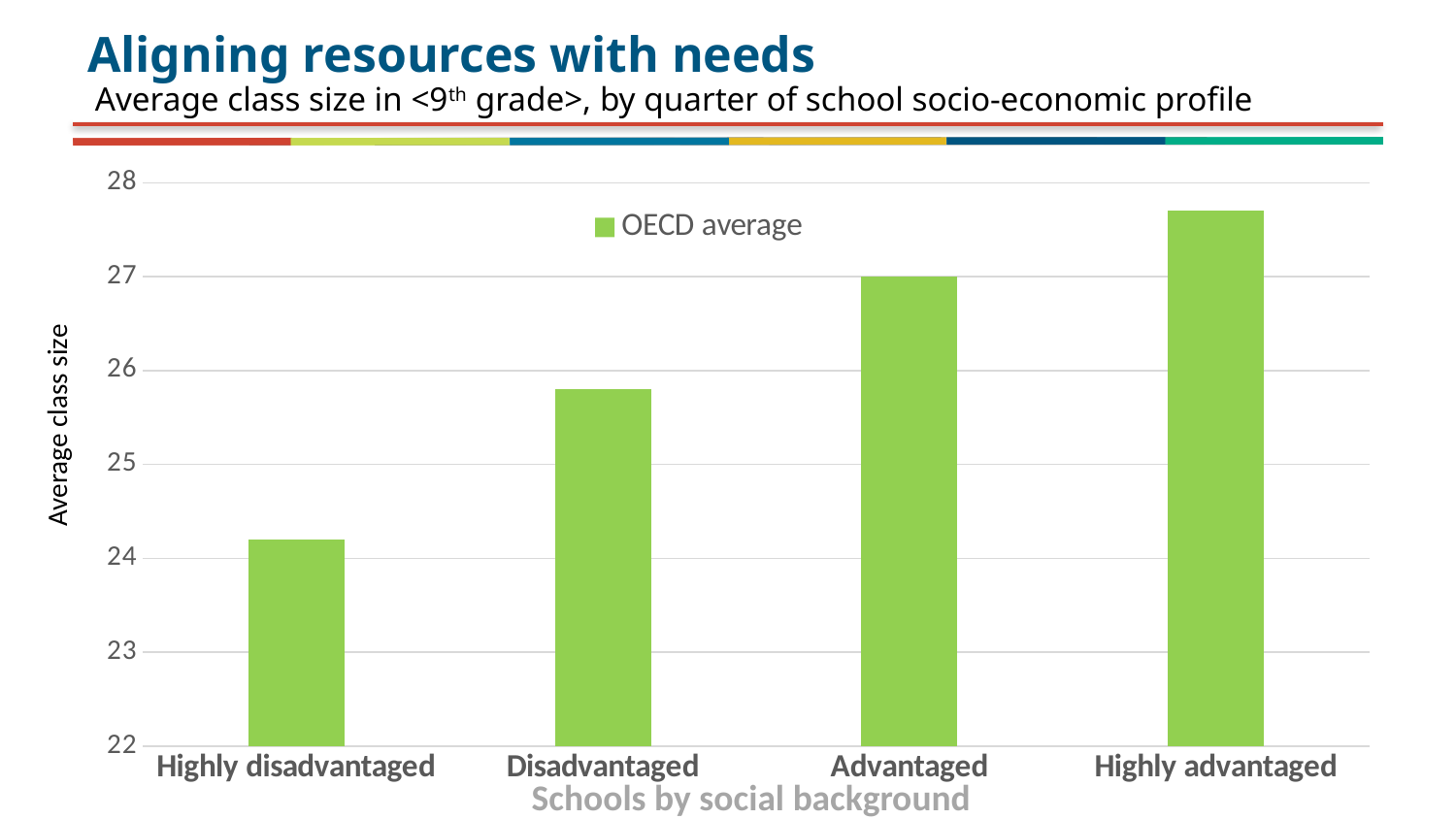
Which school category has the lowest average class size? Highly disadvantaged Do the values rise or fall moving from Highly disadvantaged to Highly advantaged along the x axis? rise Is the average class size for Disadvantaged schools greater or less than 26? less Which school category has the highest average class size? Highly advantaged Which has a larger average class size, Disadvantaged or Advantaged schools? Advantaged What series name is shown in the chart legend? OECD average How many series does the legend list? 1 What kind of chart is shown on the slide? bar chart Is the average class size for Highly advantaged schools greater or less than 27? greater Is the average class size for Highly disadvantaged schools greater or less than 25? less How many categories of schools are shown on the x axis? 4